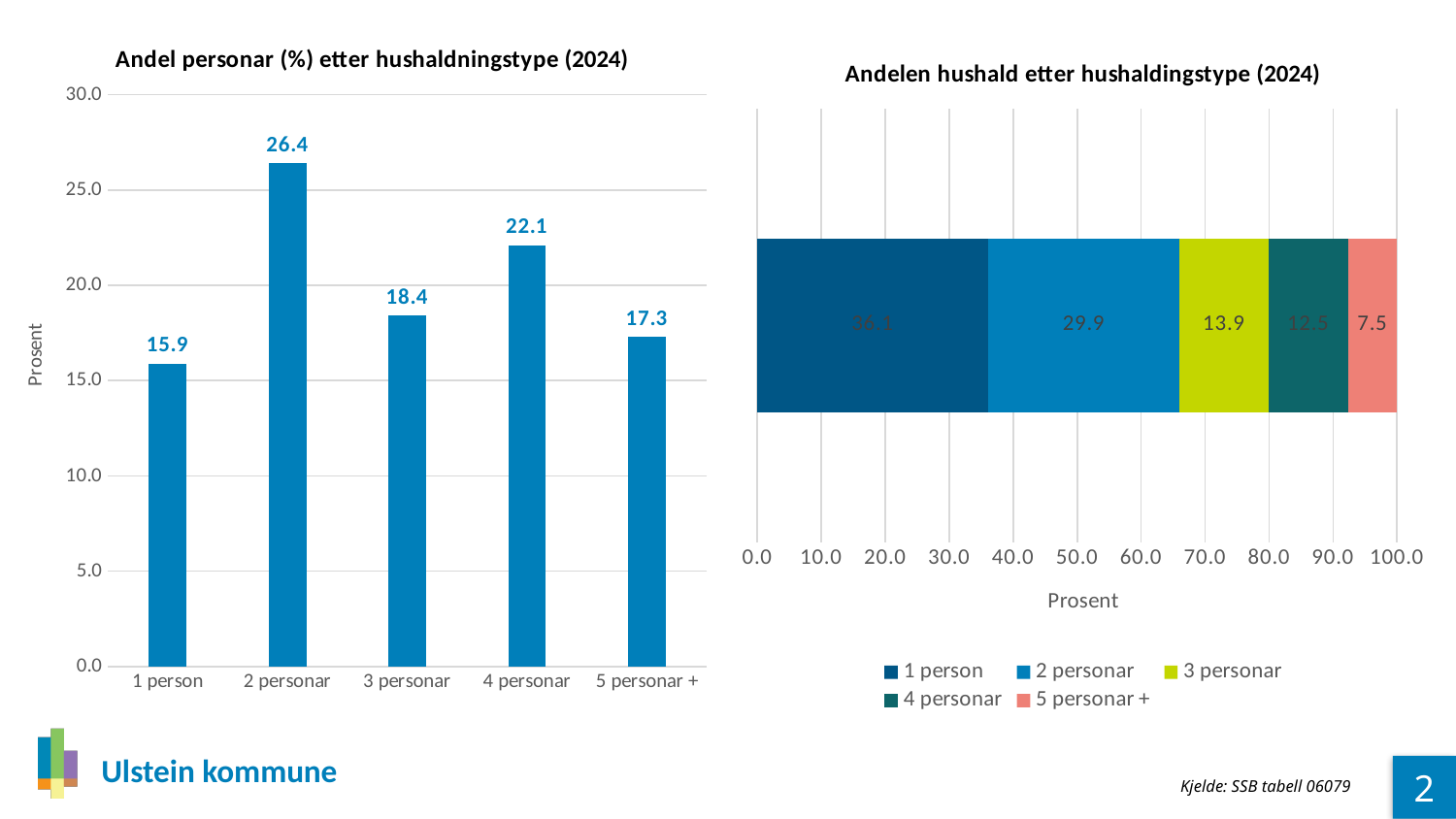
In the chart 'Andelen hushald etter hushaldingstype (2024)', which series is shown in the salmon/pink colour? 5 personar + In the chart 'Andel personar (%) etter hushaldningstype (2024)', what is the value for 2 personar? 26.4 In the chart 'Andel personar (%) etter hushaldningstype (2024)', which is larger: the value for 3 personar or the value for 5 personar +? 3 personar What kind of chart is 'Andel personar (%) etter hushaldningstype (2024)'? Bar chart In the chart 'Andelen hushald etter hushaldingstype (2024)', what is the value for 3 personar? 13.9 In the chart 'Andel personar (%) etter hushaldningstype (2024)', which household type has the highest value? 2 personar In the chart 'Andel personar (%) etter hushaldningstype (2024)', what is the value for 5 personar +? 17.3 How many series does the legend of the chart 'Andelen hushald etter hushaldingstype (2024)' list? 5 In the chart 'Andelen hushald etter hushaldingstype (2024)', what is the value for 2 personar? 29.9 In the chart 'Andel personar (%) etter hushaldningstype (2024)', which household type has the lowest value? 1 person How many household types are shown in the chart 'Andel personar (%) etter hushaldningstype (2024)'? 5 In the chart 'Andel personar (%) etter hushaldningstype (2024)', what is the difference between the values for 4 personar and 3 personar? 3.7